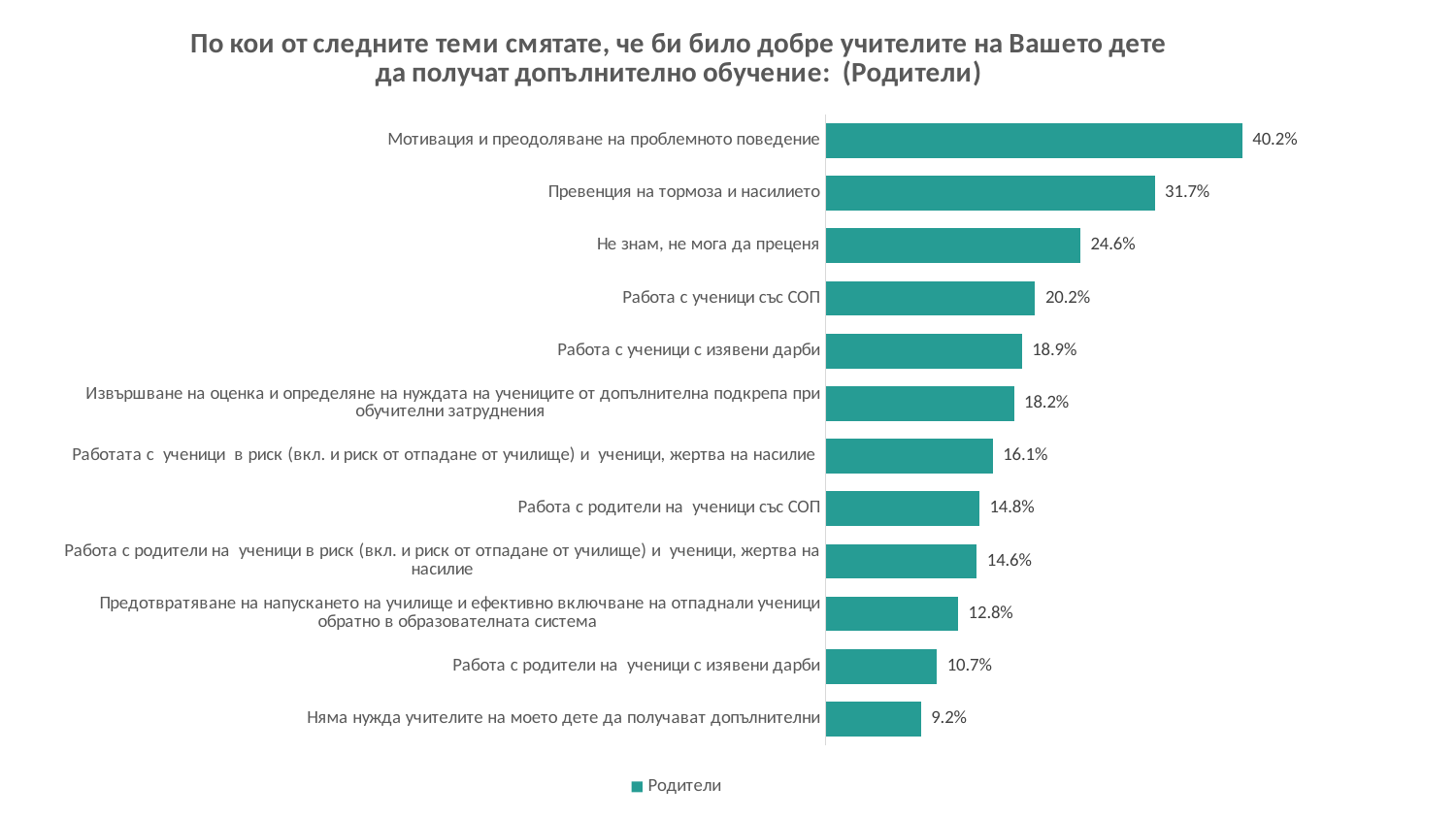
What is the difference between the values for "Мотивация и преодоляване на проблемното поведение" and "Превенция на тормоза и насилието"? 8.5% What value is shown for "Мотивация и преодоляване на проблемното поведение"? 40.2% What kind of chart is shown on the slide? Bar chart What is the difference between the values for "Работа с ученици със СОП" and "Работа с родители на ученици със СОП"? 5.4% Which is larger: the value for "Работа с ученици с изявени дарби" or the value for "Работа с родители на ученици с изявени дарби"? Работа с ученици с изявени дарби Which category has the lowest value? Няма нужда учителите на моето дете да получават допълнителни What value is shown for "Работа с родители на ученици с изявени дарби"? 10.7% How many categories are shown in the chart? 12 What value is shown for "Превенция на тормоза и насилието"? 31.7% Which category has the highest value? Мотивация и преодоляване на проблемното поведение How many series does the legend list? 1 What value is shown for "Не знам, не мога да преценя"? 24.6%